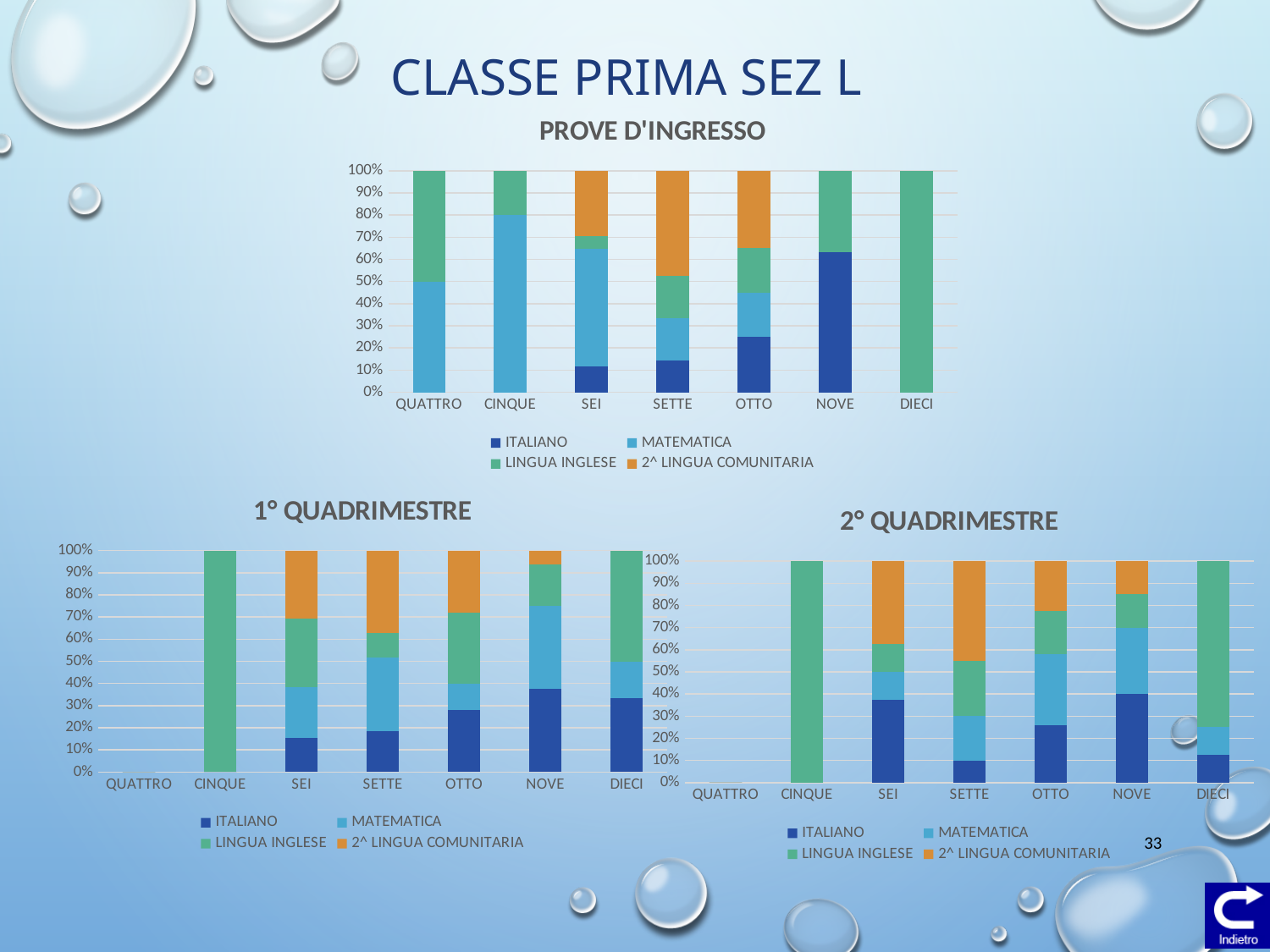
In the '2° QUADRIMESTRE' chart, which is larger: the ITALIANO value for NOVE or for SETTE? NOVE How many categories are shown on the x axis of the 'PROVE D'INGRESSO' chart? 7 In the 'PROVE D'INGRESSO' chart, is the ITALIANO value for SEI greater or less than 20%? less What kind of chart is the 'PROVE D'INGRESSO' chart? Stacked bar chart In the '1° QUADRIMESTRE' chart, is the ITALIANO value for NOVE greater or less than 30%? greater In the 'PROVE D'INGRESSO' chart, is the ITALIANO value for NOVE greater or less than 50%? greater In the 'PROVE D'INGRESSO' chart, which category has the largest ITALIANO segment? NOVE Which series is shown in orange in the legend of the '2° QUADRIMESTRE' chart? 2^ LINGUA COMUNITARIA How many series does the legend of the '1° QUADRIMESTRE' chart list? 4 In the 'PROVE D'INGRESSO' chart, which is larger: the ITALIANO value for NOVE or for SEI? NOVE